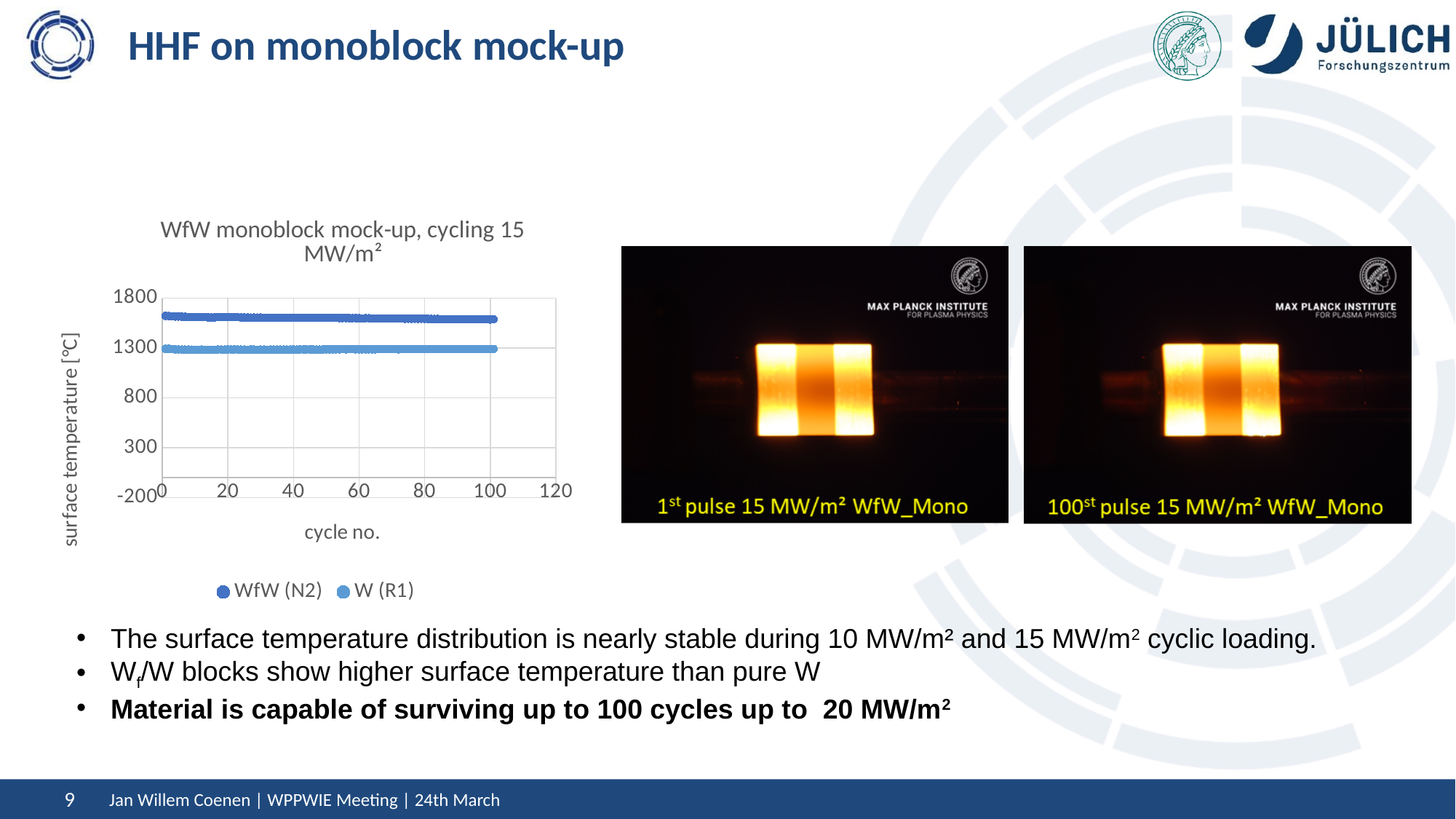
Are the surface temperature values for WfW (N2) greater or less than 1800? less Which series shows the higher surface temperature, WfW (N2) or W (R1)? WfW (N2) Are the surface temperature values for WfW (N2) greater or less than 1300? greater What is the title of the chart? WfW monoblock mock-up, cycling 15 MW/m² What are the two series named in the chart's legend? WfW (N2) and W (R1) Which series has the highest surface temperature values in the chart? WfW (N2) How many series does the chart's legend list? 2 What kind of chart is shown on the slide? scatter chart Do the surface temperature values for W (R1) rise, fall, or stay roughly flat as the cycle number increases? stay roughly flat Are the surface temperature values for W (R1) greater or less than 800? greater Which series has the lowest surface temperature values in the chart? W (R1) What is the label of the x axis of the chart? cycle no.